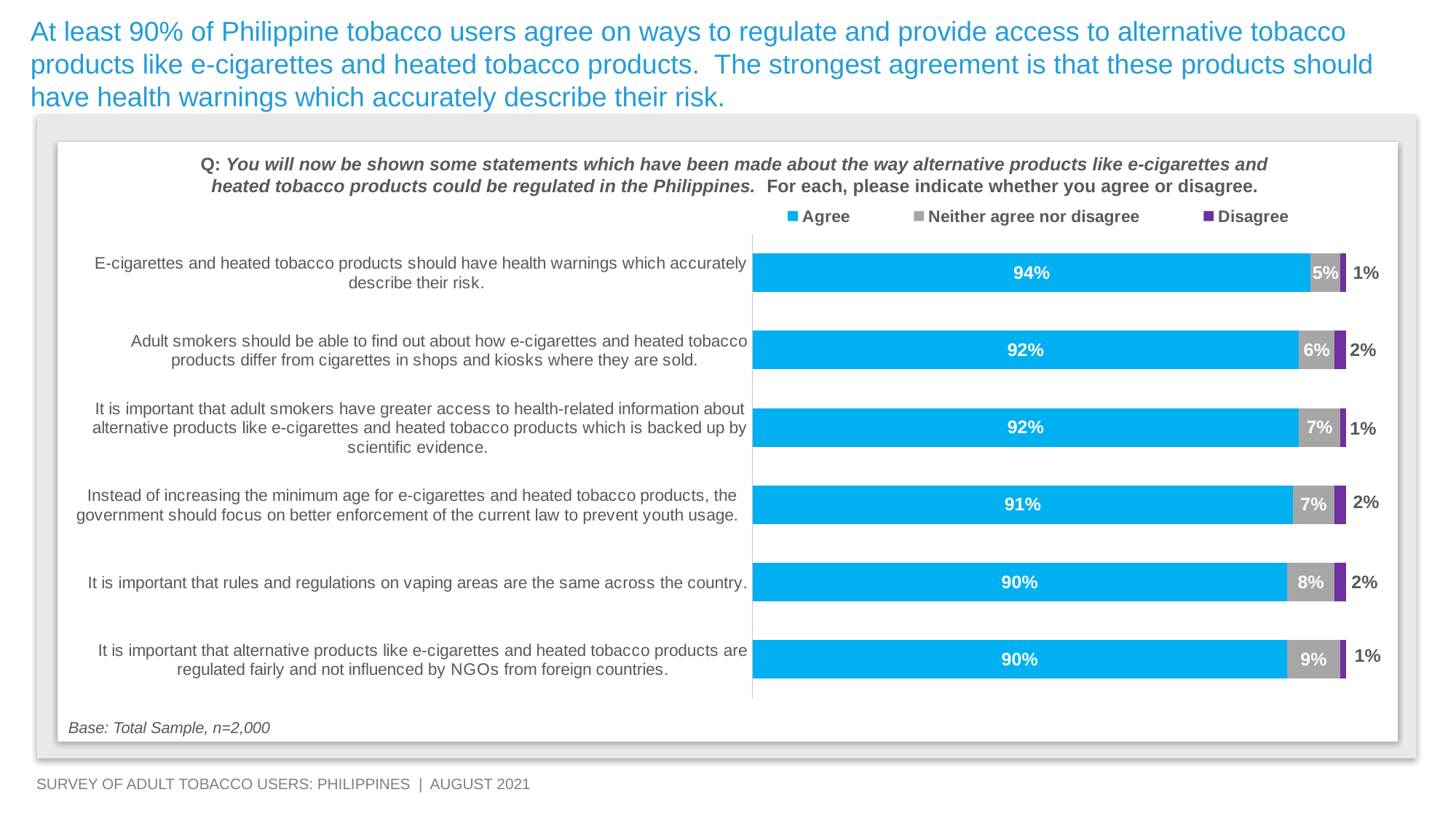
Which is larger: the Agree percentage for the health warnings statement or the Agree percentage for the statement about regulation not influenced by foreign NGOs? The health warnings statement What percentage of respondents neither agree nor disagree that rules and regulations on vaping areas should be the same across the country? 8% What percentage of respondents agree that e-cigarettes and heated tobacco products should have health warnings which accurately describe their risk? 94% How many series does the legend list? 3 What percentage of respondents agree that the government should focus on better enforcement of the current law instead of increasing the minimum age? 91% What type of chart is shown on the slide? Stacked bar chart What is the difference in Agree percentage between the health warnings statement and the vaping areas regulations statement? 4 percentage points Which statement has the highest Agree percentage? E-cigarettes and heated tobacco products should have health warnings which accurately describe their risk. How many statements are shown in the chart? 6 What percentage of respondents disagree that adult smokers should be able to find out how e-cigarettes and heated tobacco products differ from cigarettes in shops and kiosks? 2% What is the base sample size noted below the chart? Total Sample, n=2,000 Which statement has the highest Neither agree nor disagree percentage? It is important that alternative products like e-cigarettes and heated tobacco products are regulated fairly and not influenced by NGOs from foreign countries.